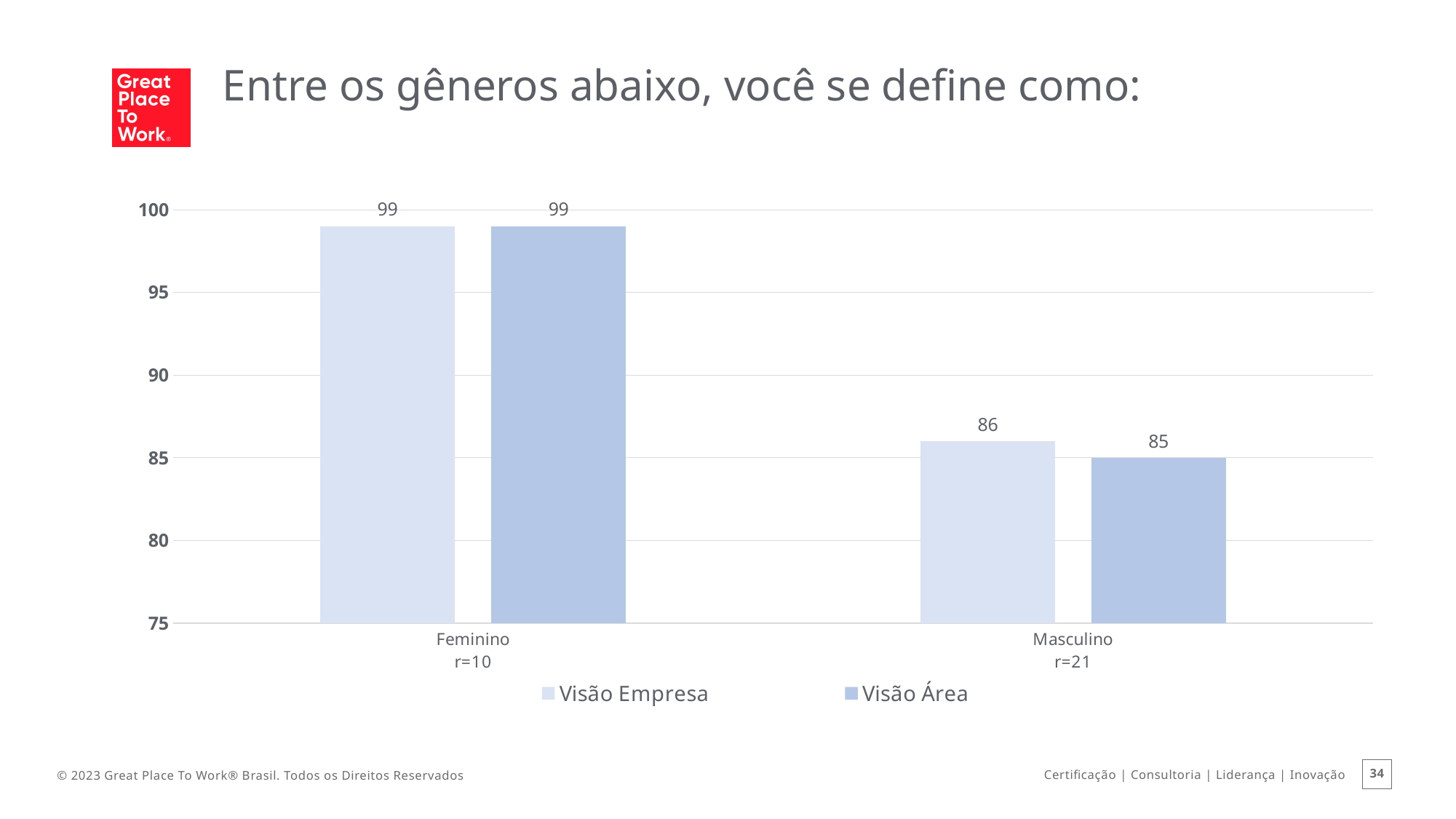
How many series does the legend list? 2 What is the Visão Área value for Feminino? 99 Is the Visão Empresa value for Feminino larger than the Visão Empresa value for Masculino? Yes Which category has the highest Visão Empresa value? Feminino What kind of chart is shown on the slide? Bar chart What is the Visão Empresa value for Masculino? 86 What is the Visão Área value for Masculino? 85 How many categories are shown on the x axis? 2 What is the Visão Empresa value for Feminino? 99 What is the difference between the Visão Empresa values for Feminino and Masculino? 13 Which category has the lowest Visão Área value? Masculino What is the difference between the Visão Empresa and Visão Área values for Masculino? 1